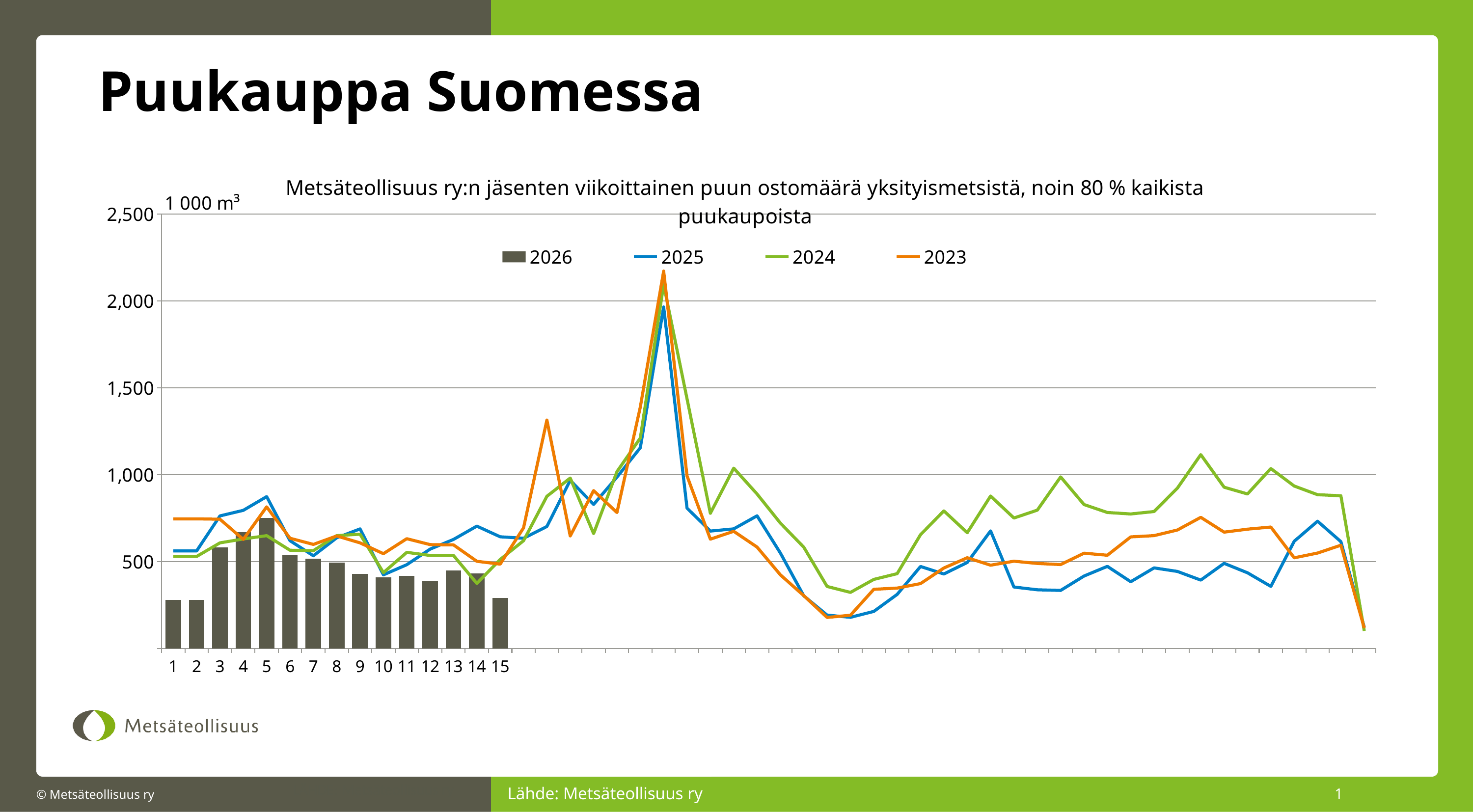
Is the 2026 value for week 10 greater or less than 500? less Is the 2026 value for week 1 greater or less than 500? less How many series does the legend list? 4 What kind of chart is shown on the slide? A combination of a bar chart and a line chart How many weeks have a bar plotted for the 2026 series? 15 Which series reaches the highest peak on the chart? 2023 Is the 2026 value for week 5 greater or less than 500? greater Which series are listed in the legend? 2026, 2025, 2024, 2023 Which is larger for 2026: the value for week 5 or the value for week 15? Week 5 Do the 2026 bars rise or fall from week 5 to week 12? Fall Which week has the highest 2026 bar? 5